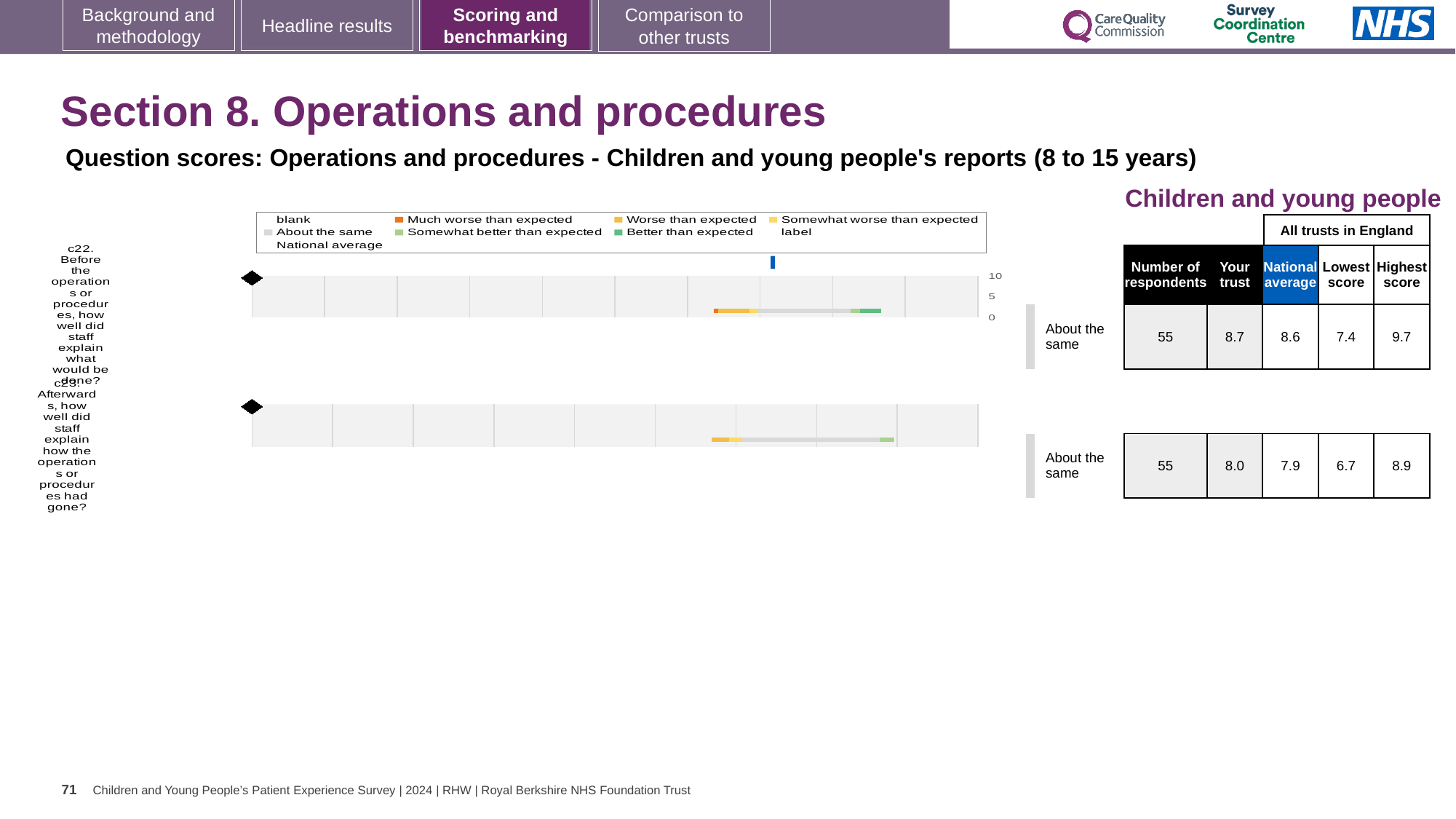
For question c22, what is the difference between the Highest score and the Lowest score across all trusts in England? 2.3 For question c23 (Afterwards, how well did staff explain how the operations or procedures had gone?), what is the 'Your trust' score? 8.0 What kind of chart is used to show the benchmarking results for questions c22 and c23? bar chart For question c23, what is the Lowest score across all trusts in England? 6.7 For question c23, what is the National average score? 7.9 What benchmarking category is shown next to the bar for question c22? About the same For question c22 (Before the operations or procedures, how well did staff explain what would be done?), what is the 'Your trust' score? 8.7 For question c22, what is the National average score? 8.6 How many respondents answered question c22? 55 For question c23, which is larger: the 'Your trust' score or the National average? Your trust How many entries does the chart legend list? 9 How many questions (c22 and c23) are plotted as separate bars on the slide? 2